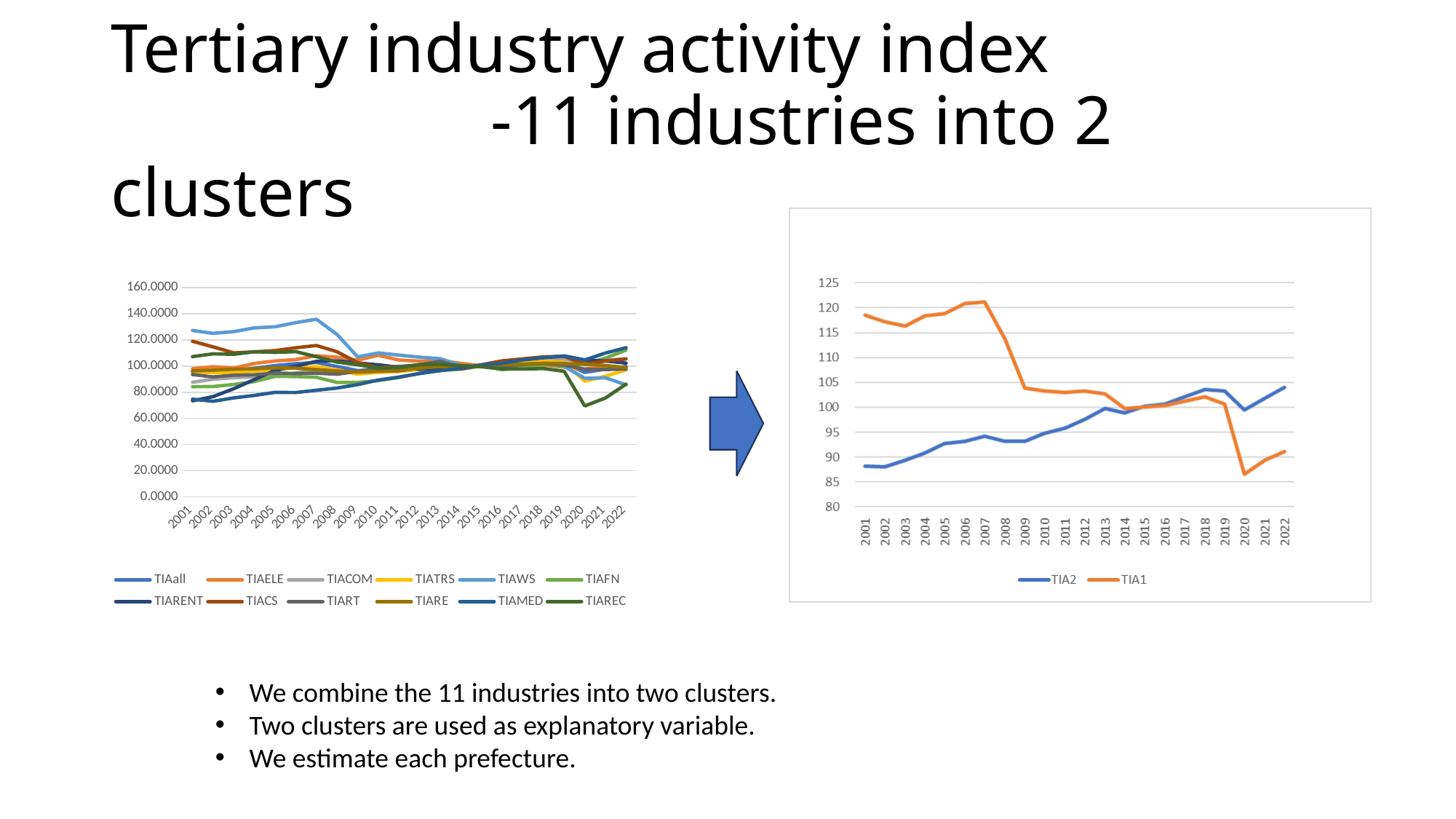
How many series does the legend of the chart on the right list? 2 In the chart on the right, in which year does TIA1 reach its lowest value? 2020 In the chart on the right, which series has the larger value in 2022, TIA1 or TIA2? TIA2 What kind of chart is the chart on the right of the slide? line chart In the chart on the left, is the value of TIAWS in 2007 greater or less than 120.0000? greater In the chart on the right, does TIA2 generally rise or fall from 2001 to 2022? rise How many years are shown on the x axis of the chart on the right? 22 How many series does the legend of the chart on the left list? 12 In the chart on the right, is the value of TIA2 in 2001 greater or less than 90? less In the chart on the right, is the value of TIA1 in 2020 greater or less than 90? less In the chart on the right, in which year does TIA1 reach its highest value? 2007